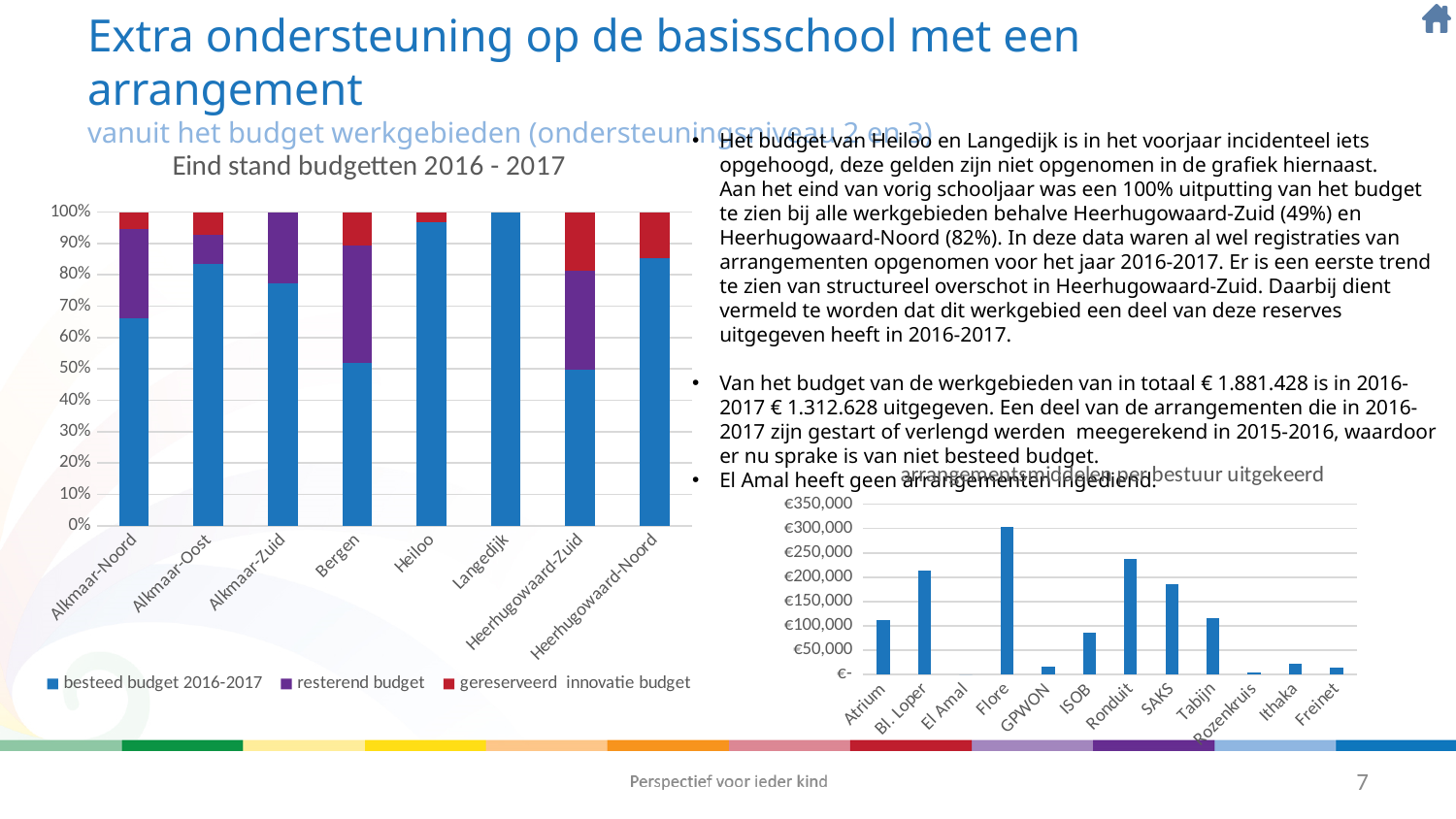
On the chart titled 'arrangementsmiddelen per bestuur uitgekeerd', which bestuur received the highest amount? Flore On the chart titled 'arrangementsmiddelen per bestuur uitgekeerd', how many besturen (categories) are shown on the x axis? 12 On the chart titled 'Eind stand budgetten 2016 - 2017', which werkgebied has the highest share of 'besteed budget 2016-2017'? Langedijk On the chart titled 'Eind stand budgetten 2016 - 2017', how many werkgebieden (categories) are shown on the x axis? 8 On the chart titled 'Eind stand budgetten 2016 - 2017', how many series does the legend list? 3 On the chart titled 'arrangementsmiddelen per bestuur uitgekeerd', is the value for ISOB greater or less than €100,000? less On the chart titled 'arrangementsmiddelen per bestuur uitgekeerd', is the value for Flore greater or less than €250,000? greater On the chart titled 'Eind stand budgetten 2016 - 2017', what colour represents 'gereserveerd innovatie budget'? red On the chart titled 'arrangementsmiddelen per bestuur uitgekeerd', which has the larger value: Ronduit or SAKS? Ronduit What kind of chart is 'Eind stand budgetten 2016 - 2017'? stacked bar chart On the chart titled 'Eind stand budgetten 2016 - 2017', is the 'besteed budget 2016-2017' share for Alkmaar-Noord greater or less than 60%? greater On the chart titled 'Eind stand budgetten 2016 - 2017', which has the larger 'besteed budget 2016-2017' share: Alkmaar-Oost or Alkmaar-Noord? Alkmaar-Oost